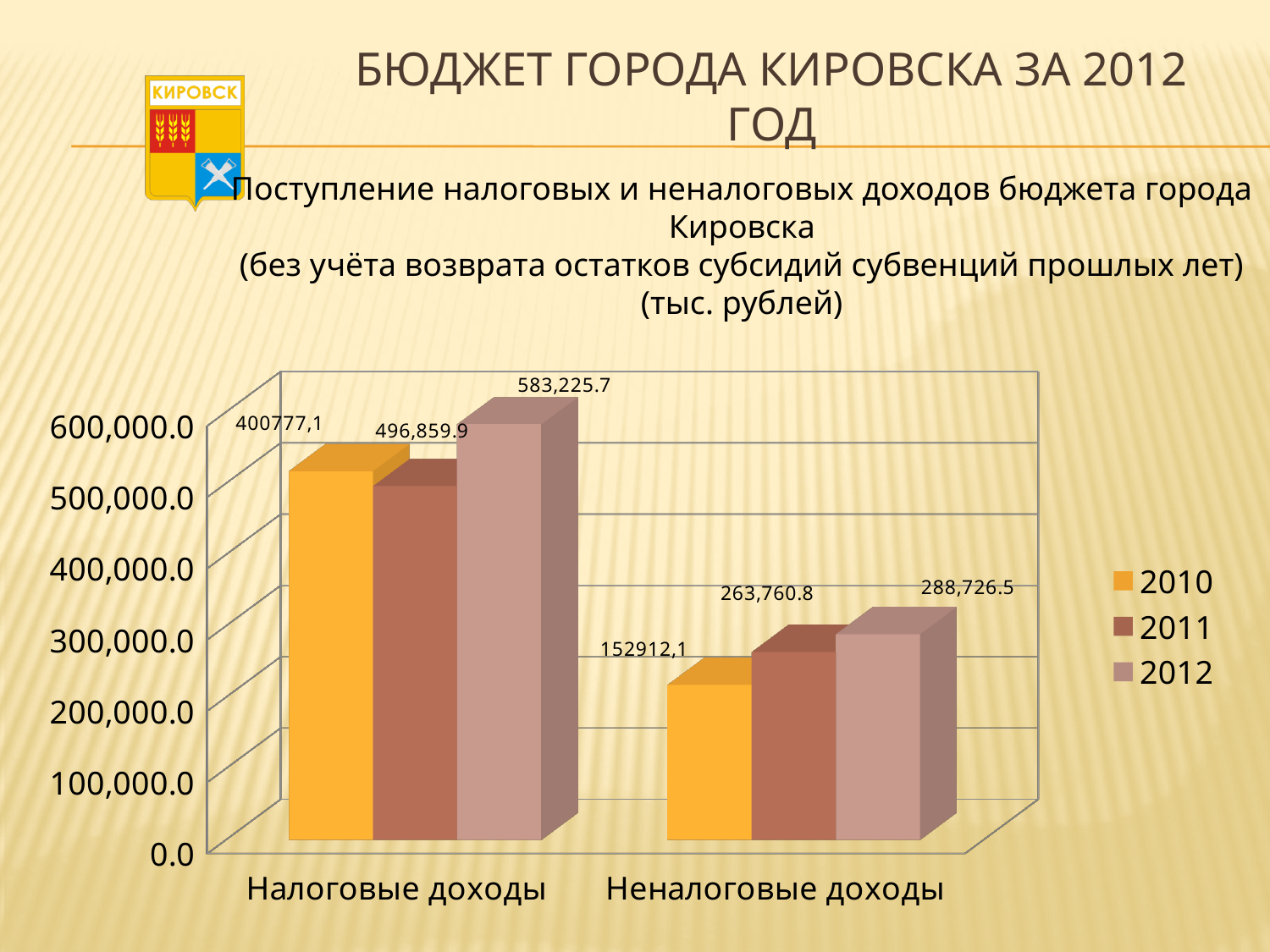
What is the value for Налоговые доходы in 2012? 583,225.7 What is the difference between the 2012 and 2011 values for Налоговые доходы? 86,365.8 What type of chart is shown on the slide? Bar chart How many series does the legend list? 3 Which year has the lowest value for Неналоговые доходы? 2010 Which year has the highest value for Налоговые доходы? 2012 What is the value for Налоговые доходы in 2011? 496,859.9 What is the value for Неналоговые доходы in 2011? 263,760.8 How many categories are shown on the x axis? 2 What is the value for Неналоговые доходы in 2012? 288,726.5 Do the values for Неналоговые доходы rise or fall from 2010 to 2012? Rise